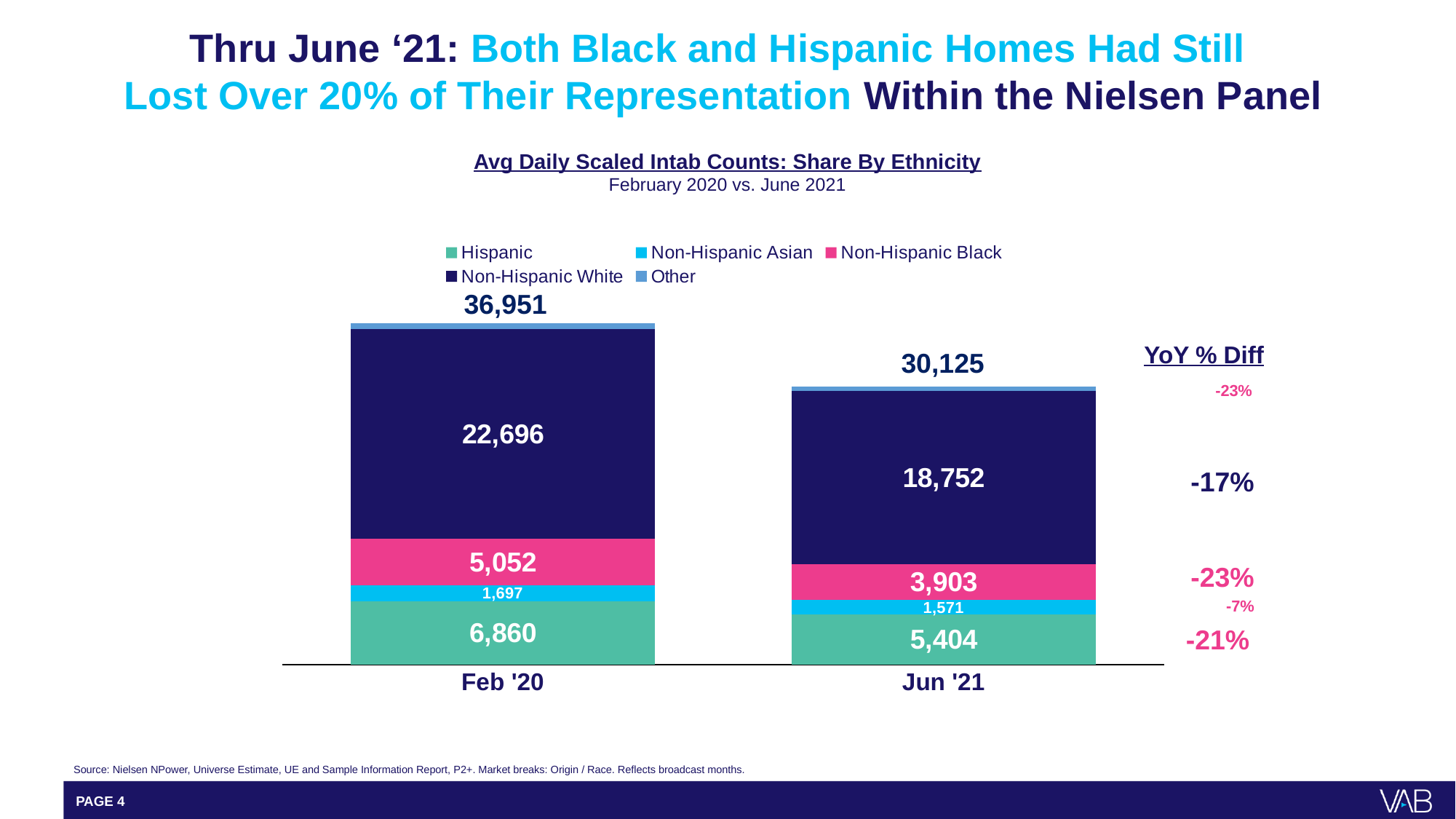
What is the Non-Hispanic White value for Jun '21? 18,752 What YoY % Diff is shown for Hispanic? -21% What is the total for the Jun '21 bar? 30,125 How many series does the legend list? 5 Which series has the largest segment in the Jun '21 bar? Non-Hispanic White What is the Hispanic value for Feb '20? 6,860 What is the Non-Hispanic Asian value for Feb '20? 1,697 Is the Non-Hispanic Black value larger in Feb '20 or Jun '21? Feb '20 What is the Non-Hispanic Black value for Jun '21? 3,903 What is the difference between the Hispanic values for Feb '20 and Jun '21? 1,456 What is the total for the Feb '20 bar? 36,951 What kind of chart is shown? Stacked bar chart